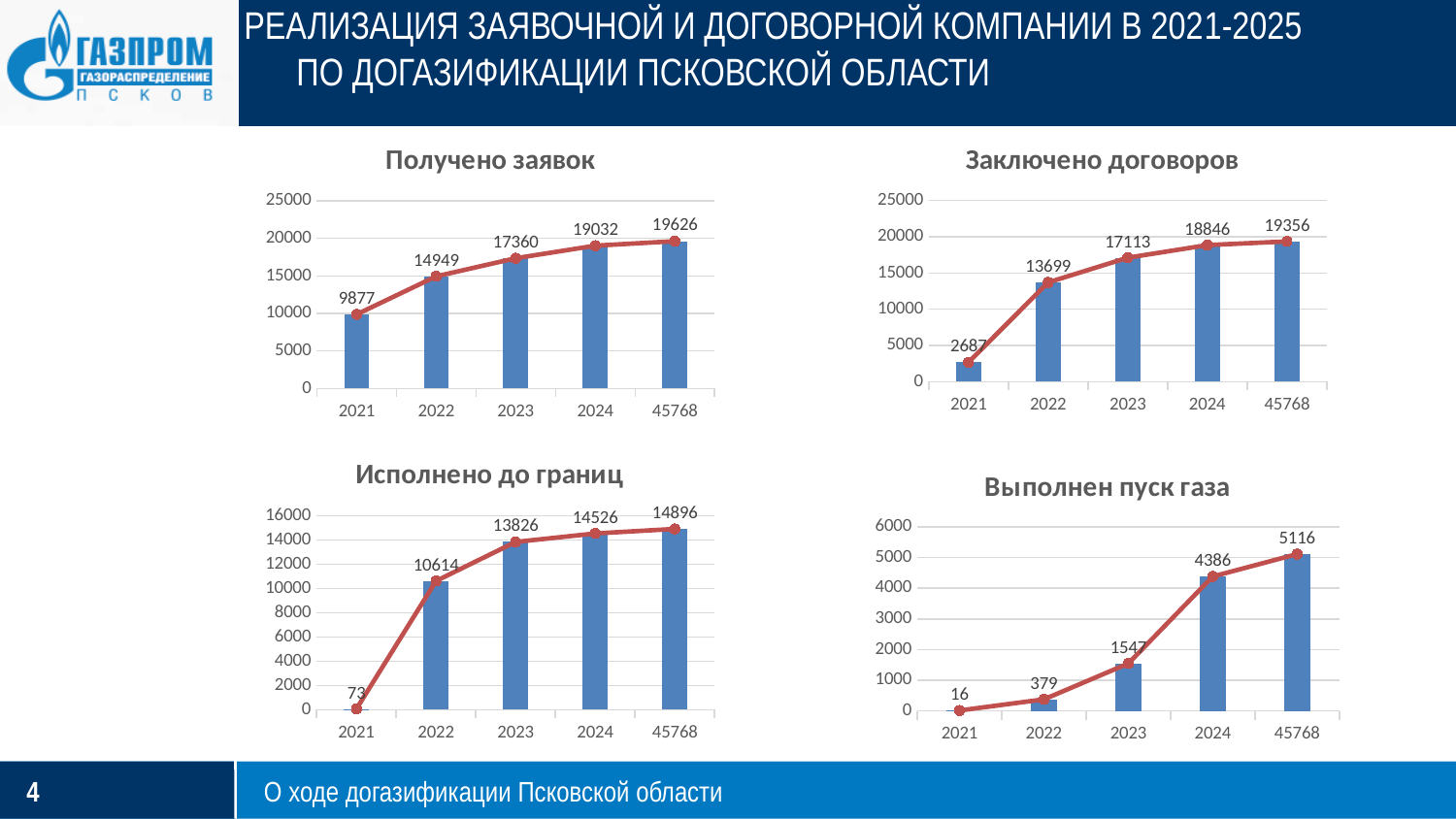
In the chart titled "Получено заявок", what is the difference between the values for 2022 and 2021? 5072 What kind of chart is the chart titled "Заключено договоров"? bar chart with a line In the chart titled "Заключено договоров", what is the difference between the values for 2024 and 2023? 1733 In the chart titled "Выполнен пуск газа", which category has the lowest value? 2021 How many categories are shown on the x axis of the chart titled "Исполнено до границ"? 5 In the chart titled "Получено заявок", what is the value for 2023? 17360 In the chart titled "Исполнено до границ", which is larger, the value for 2023 or the value for 2024? 2024 In the chart titled "Заключено договоров", what is the value for 2021? 2687 In the chart titled "Выполнен пуск газа", do the values rise or fall from 2021 to the last category? rise In the chart titled "Исполнено до границ", what is the value for 2022? 10614 In the chart titled "Получено заявок", which category has the highest value? 45768 In the chart titled "Выполнен пуск газа", what is the value for 2024? 4386